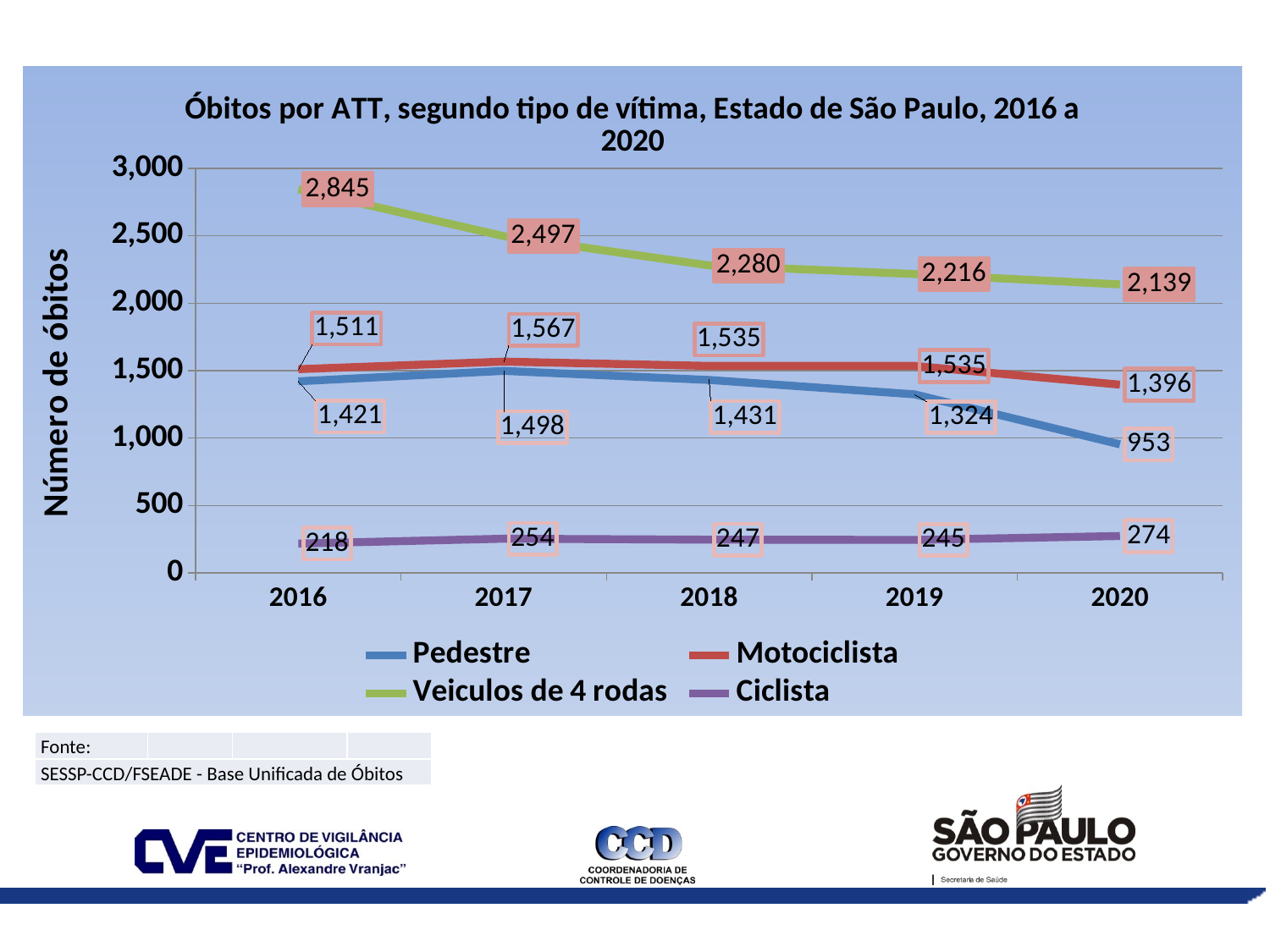
What is the value for Veiculos de 4 rodas in 2016? 2,845 What type of chart is shown on the slide? line chart What is the value for Motociclista in 2020? 1,396 Does the value for Pedestre rise or fall from 2017 to 2020? fall How many series does the legend list? 4 How many years are plotted on the x axis? 5 What is the difference between the Veiculos de 4 rodas values in 2016 and 2020? 706 In which year is the value for Veiculos de 4 rodas lowest? 2020 Which is larger in 2019, the value for Motociclista or the value for Pedestre? Motociclista In which year is the value for Ciclista highest? 2020 What is the value for Ciclista in 2017? 254 What is the value for Pedestre in 2020? 953